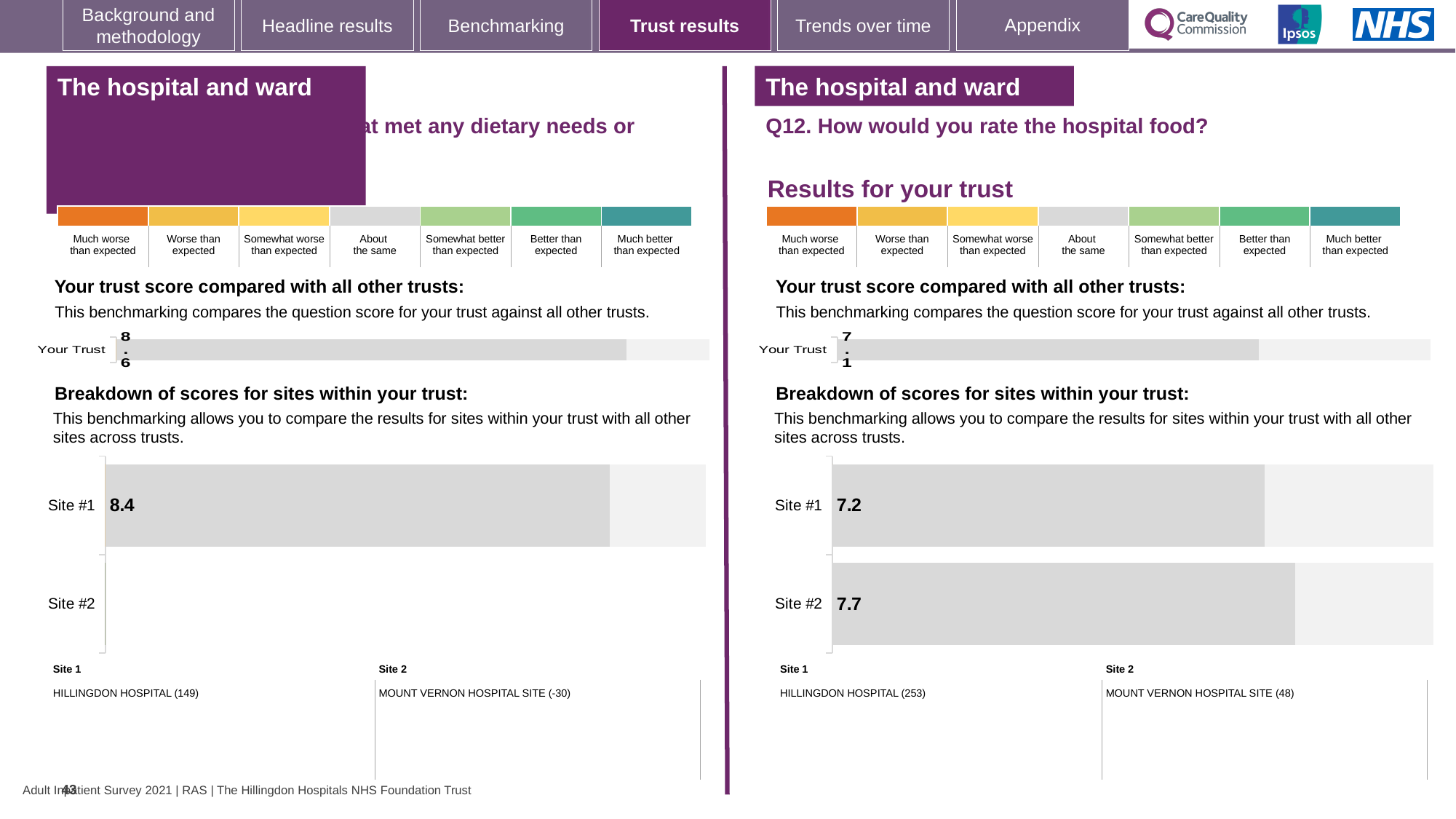
On the right-hand 'Your trust score compared with all other trusts' chart for Q12, what is the score shown for Your Trust? 7.1 How many sites are listed on the right-hand 'Breakdown of scores for sites within your trust' chart for Q12? 2 On the left-hand 'Breakdown of scores for sites within your trust' chart, what is the score for Site #1? 8.4 On the left-hand 'Your trust score compared with all other trusts' chart, what is the score shown for Your Trust? 8.6 On the right-hand chart for Q12 (hospital food), what is the difference between the Site #2 score and the Site #1 score? 0.5 On the right-hand chart for Q12 (hospital food), which site has the lowest score? Site #1 On the right-hand chart for Q12 (hospital food), what is the score for Site #2? 7.7 On the left-hand side of the slide, which hospital is listed as Site 2? MOUNT VERNON HOSPITAL SITE (-30) On the right-hand side of the slide, which hospital is listed as Site 1 for Q12? HILLINGDON HOSPITAL (253) What kind of chart is used for the 'Breakdown of scores for sites within your trust' on the right-hand side of the slide? Bar chart On the right-hand chart for Q12 (hospital food), which site has the higher score, Site #1 or Site #2? Site #2 On the right-hand chart for Q12 (hospital food), what is the score for Site #1? 7.2